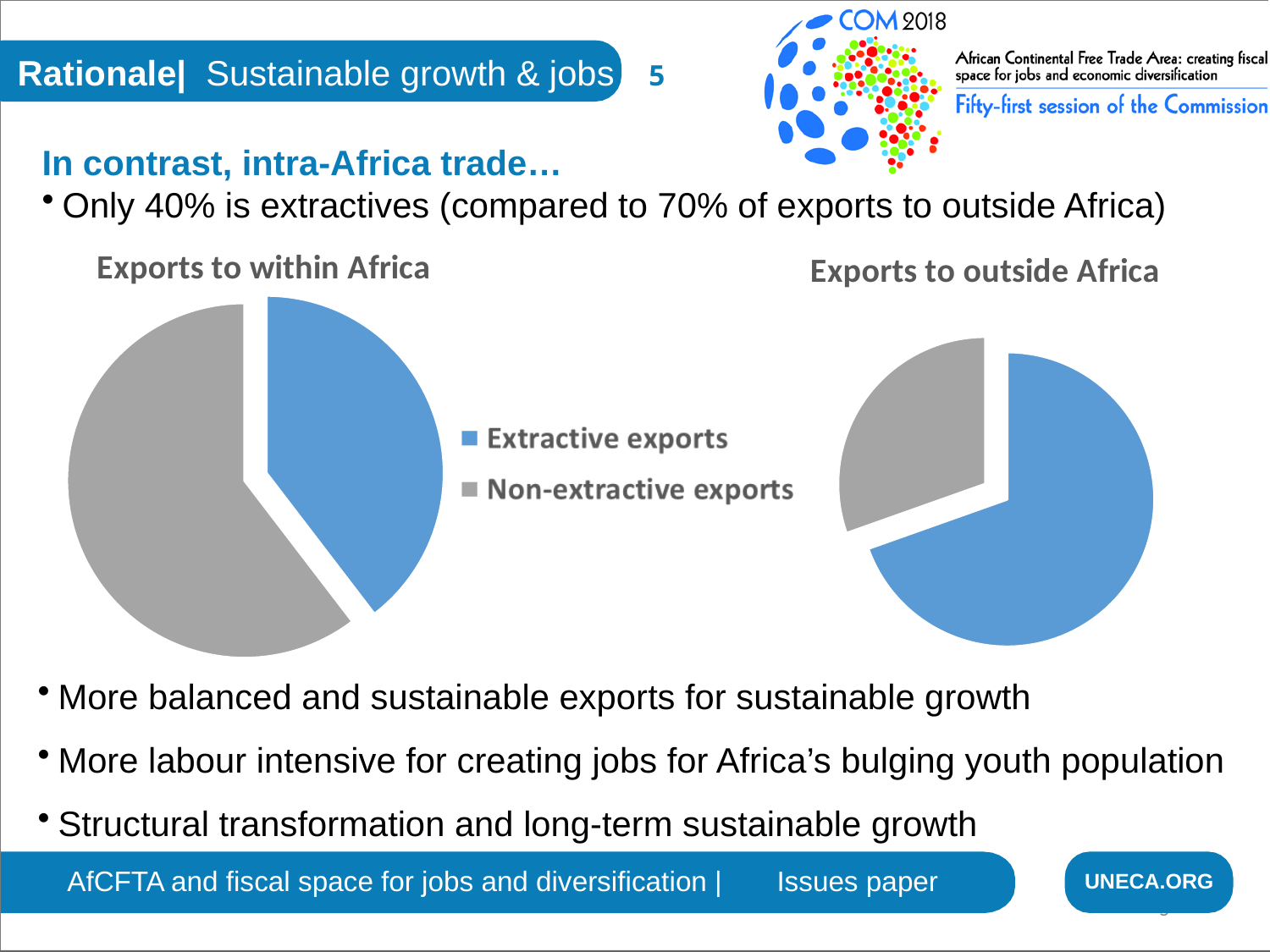
What kind of chart is "Exports to within Africa"? Pie chart According to the slide, what share of exports to outside Africa is extractives? 70% In the "Exports to within Africa" chart, which slice is larger: Extractive exports or Non-extractive exports? Non-extractive exports In the "Exports to outside Africa" chart, which category has the largest share? Extractive exports Which colour represents Extractive exports in the pie charts? Blue According to the slide, what share of exports to within Africa is extractives? 40% What is the title of the pie chart on the right? Exports to outside Africa How many slices does the "Exports to within Africa" pie chart have? 2 How many series does the legend list for the pie charts? 2 What kind of chart is "Exports to outside Africa"? Pie chart In the "Exports to within Africa" chart, which category has the smallest share? Extractive exports In the "Exports to outside Africa" chart, which slice is larger: Extractive exports or Non-extractive exports? Extractive exports